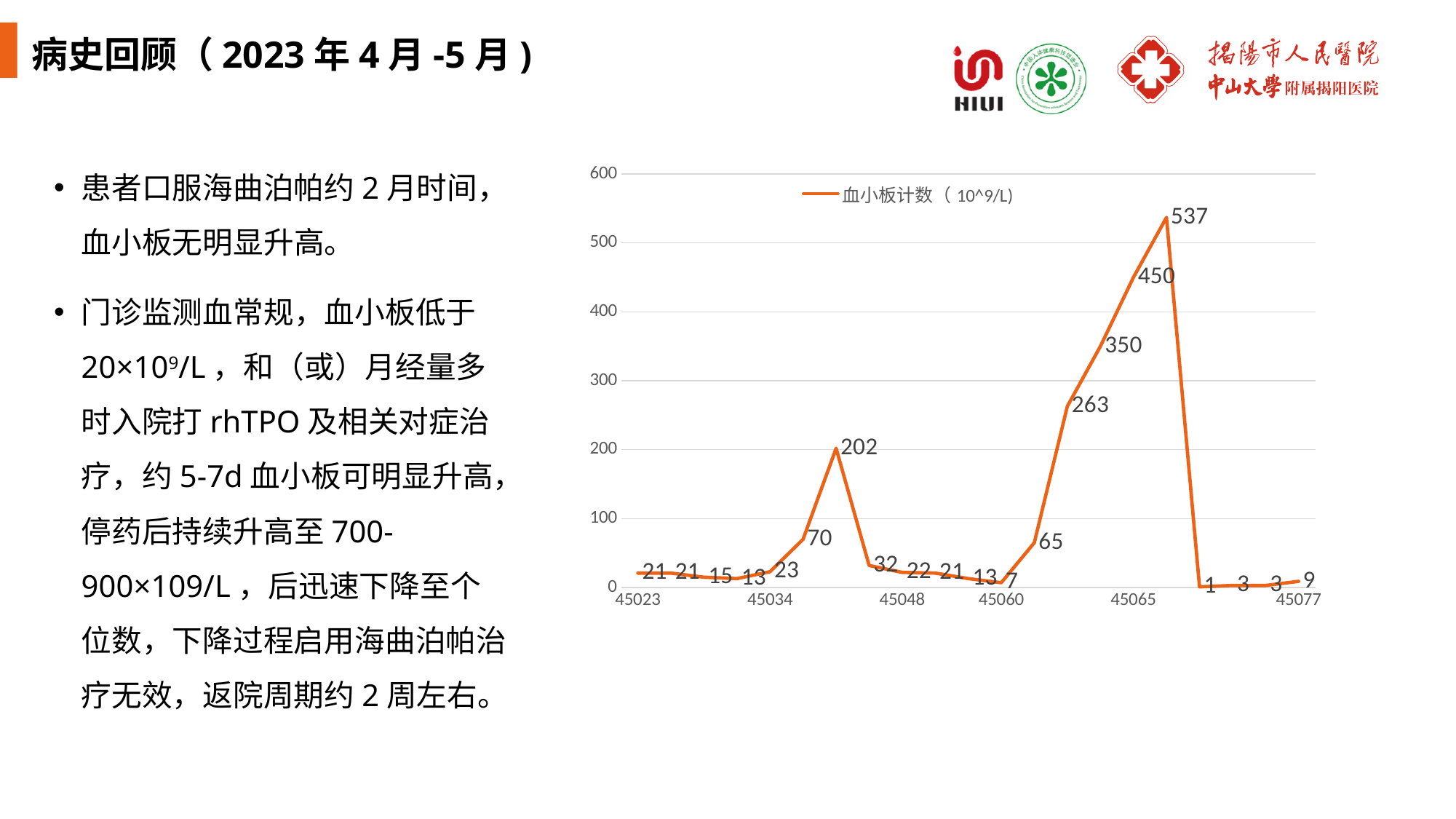
What is the value of the last data point on the chart (at 45077)? 9 What is the lowest platelet count value labelled on the chart? 1 What kind of chart is shown on the slide? line chart What is the highest platelet count value labelled on the chart? 537 What is the name of the series shown in the chart legend? 血小板计数（10^9/L） Which is larger, the first peak value of 202 or the later value of 263? 263 After reaching the peak of 537, does the platelet count rise or fall at the next point? fall What is the value of the first data point on the chart (at 45023)? 21 Is the peak value of the platelet count greater or less than 500? greater How many series does the chart legend list? 1 How many data points are labelled on the line? 21 What is the difference between the peak value 537 and the preceding value 450? 87